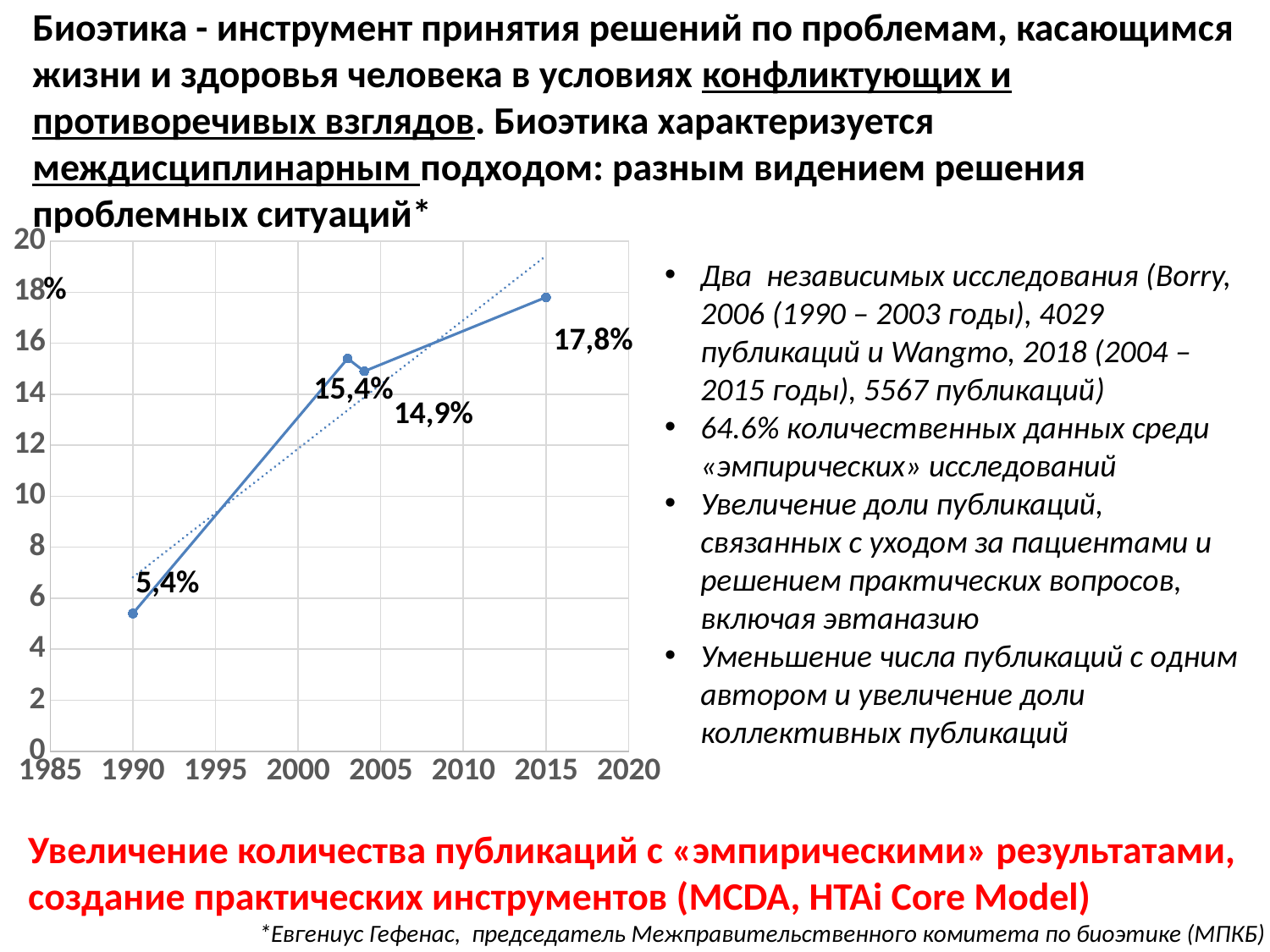
What is the value of the second data point on the line (the one just after 2000)? 15,4% Which is larger: the value at 1990 or the value at 2015? 2015 Overall, do the values rise or fall from 1990 to 2015? rise Which data point has the lowest value? 1990 (5,4%) Is the value at 1990 greater or less than 10? less Which data point has the highest value? 2015 (17,8%) How many data points are plotted on the line in the chart? 4 What is the value of the data point at 1990? 5,4% What is the value of the data point at 2015? 17,8% What is the difference between the value at 2015 and the value at 1990? 12,4% What type of chart is shown on the slide? line chart What is the difference between the points labelled 15,4% and 14,9%? 0,5%